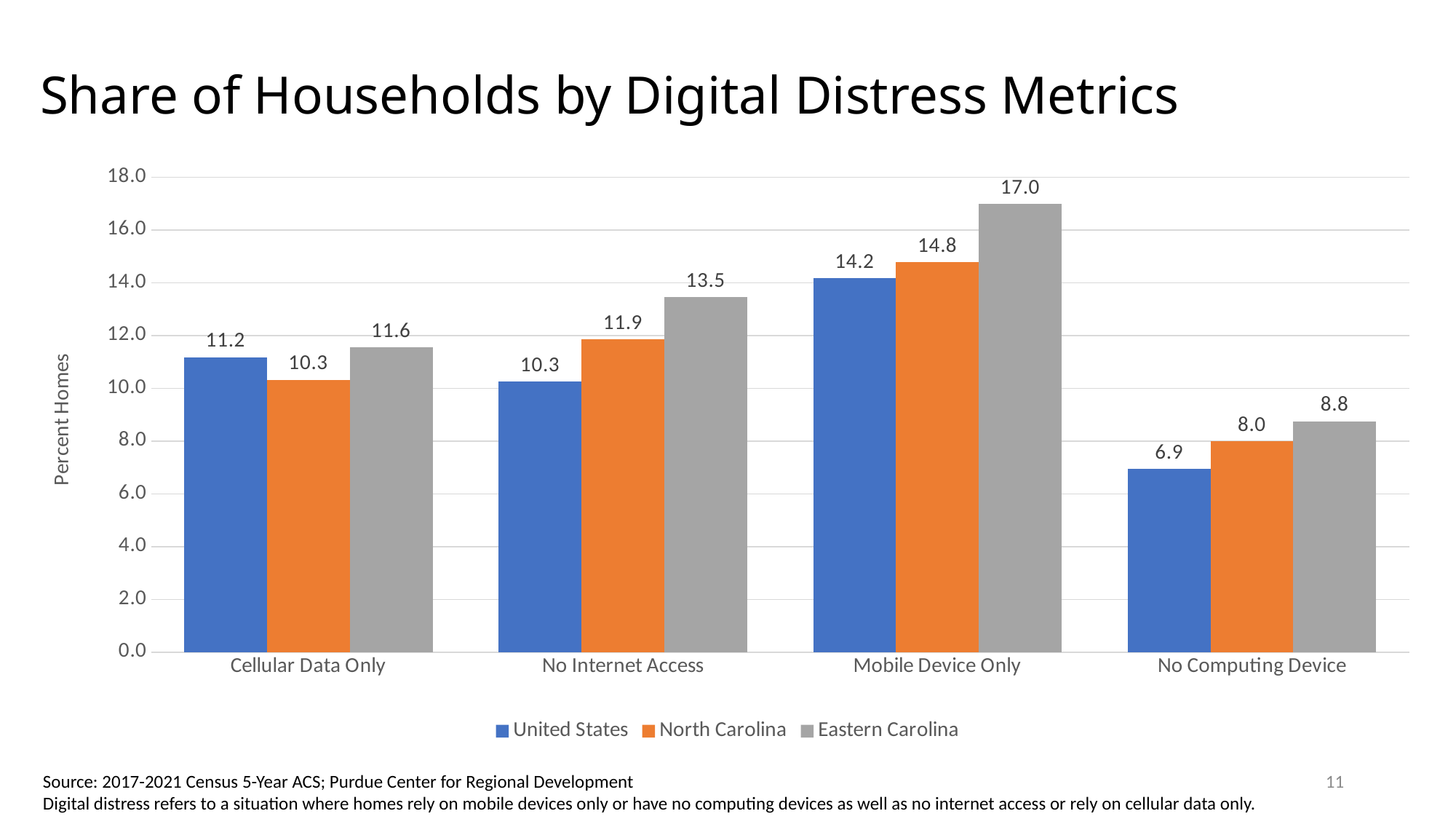
Which is larger in the Cellular Data Only category: United States or North Carolina? United States What is the label of the y axis? Percent Homes What is the difference between the Eastern Carolina and United States values in the No Internet Access category? 3.2 What is the value for Eastern Carolina in the Mobile Device Only category? 17.0 How many series does the legend list? 3 What kind of chart is shown on the slide? Bar chart Which category has the highest value for Eastern Carolina? Mobile Device Only What is the value for North Carolina in the No Internet Access category? 11.9 Is the value for North Carolina in the Mobile Device Only category greater or less than 14.0? greater What is the value for United States in the No Computing Device category? 6.9 How many categories are shown on the x axis? 4 Which category has the lowest value for United States? No Computing Device